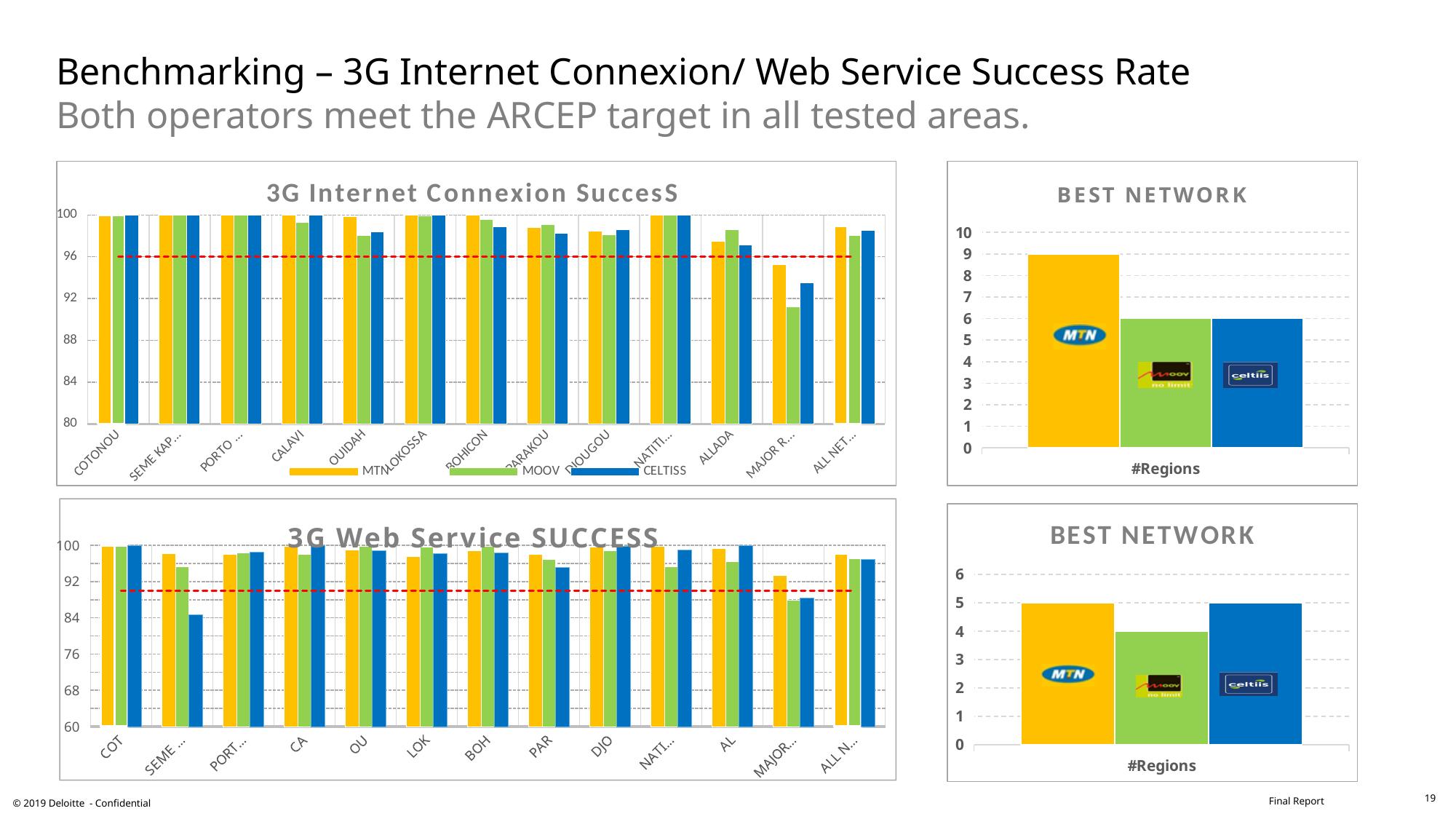
In the top-right BEST NETWORK chart, what is the value for MOOV? 6 In the 3G Internet Connexion SuccesS chart, is the CELTISS value for MAJOR R... greater or less than 96? less How many categories are shown on the x axis of the 3G Internet Connexion SuccesS chart? 13 In the bottom-right BEST NETWORK chart, what is the difference between the MTN and MOOV values? 1 In the bottom-right BEST NETWORK chart, which network has the lowest number of regions? MOOV In the top-right BEST NETWORK chart, which network has the highest number of regions? MTN In the top-right BEST NETWORK chart, what is the value for MTN? 9 How many series does the legend of the 3G Internet Connexion SuccesS chart list? 3 In the 3G Internet Connexion SuccesS chart, for MAJOR R..., which is larger: the MTN value or the MOOV value? MTN In the bottom-right BEST NETWORK chart, what is the value for MOOV? 4 In the top-right BEST NETWORK chart, what is the difference between the MTN and MOOV values? 3 What kind of chart is the 3G Web Service SUCCESS chart? bar chart